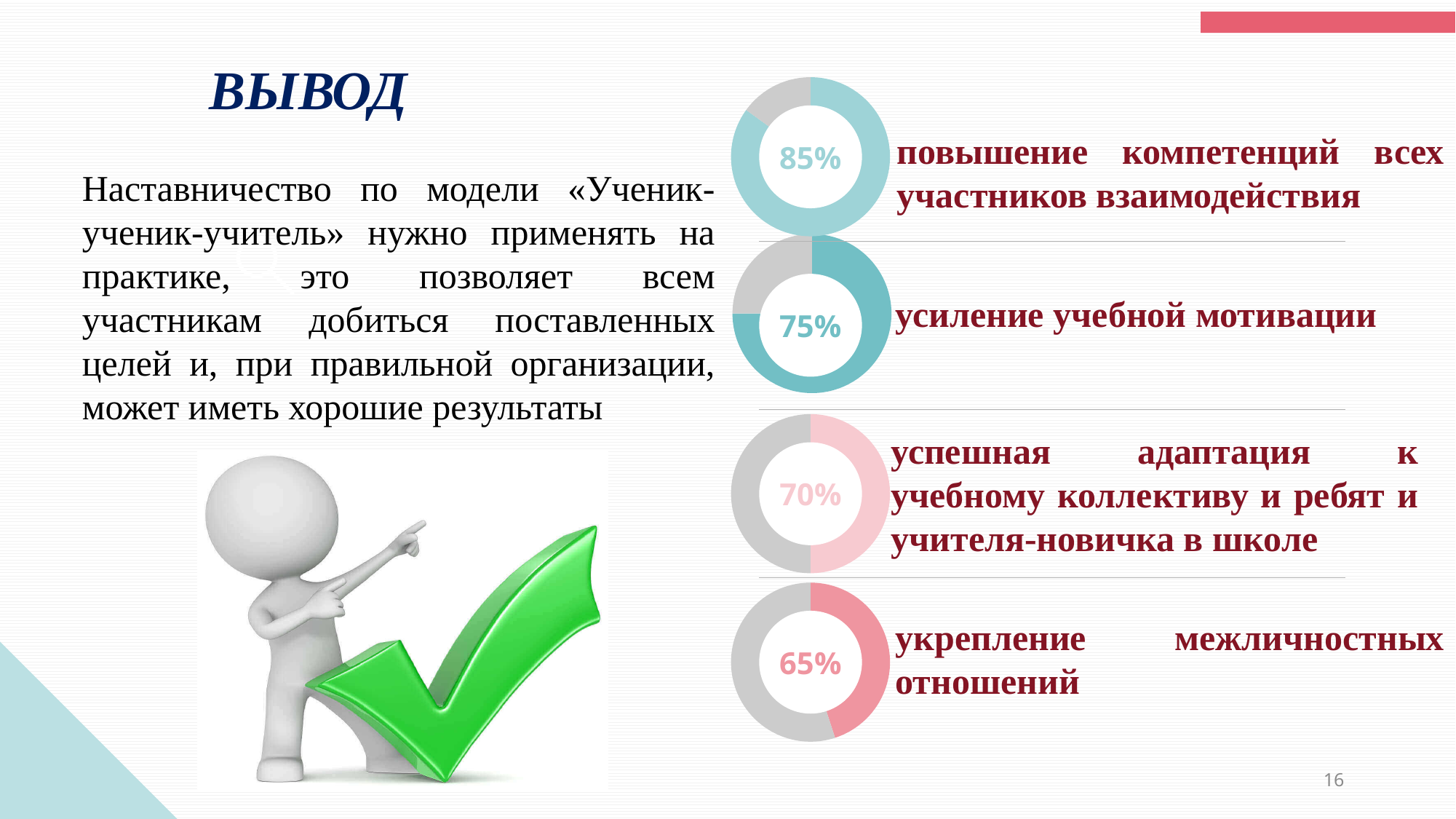
What percentage is shown in the donut chart next to "повышение компетенций всех участников взаимодействия"? 85% Which is larger: the percentage for "усиление учебной мотивации" or the percentage for "укрепление межличностных отношений"? усиление учебной мотивации Which of the four donut charts on the right shows the lowest percentage? укрепление межличностных отношений (65%) What colour is the filled portion of the donut chart showing 65%? Pink How many donut charts are shown on the right side of the slide? 4 What is the difference between the percentage for "усиление учебной мотивации" and the percentage for "успешная адаптация к учебному коллективу и ребят и учителя-новичка в школе"? 5% What is the difference between the percentage for "повышение компетенций всех участников взаимодействия" and the percentage for "укрепление межличностных отношений"? 20% What percentage is shown in the donut chart next to "успешная адаптация к учебному коллективу и ребят и учителя-новичка в школе"? 70% What percentage is shown in the donut chart next to "укрепление межличностных отношений"? 65% What kind of chart is used to display the percentages on the right side of the slide? Donut chart Which of the four donut charts on the right shows the highest percentage? повышение компетенций всех участников взаимодействия (85%) What percentage is shown in the donut chart next to "усиление учебной мотивации"? 75%